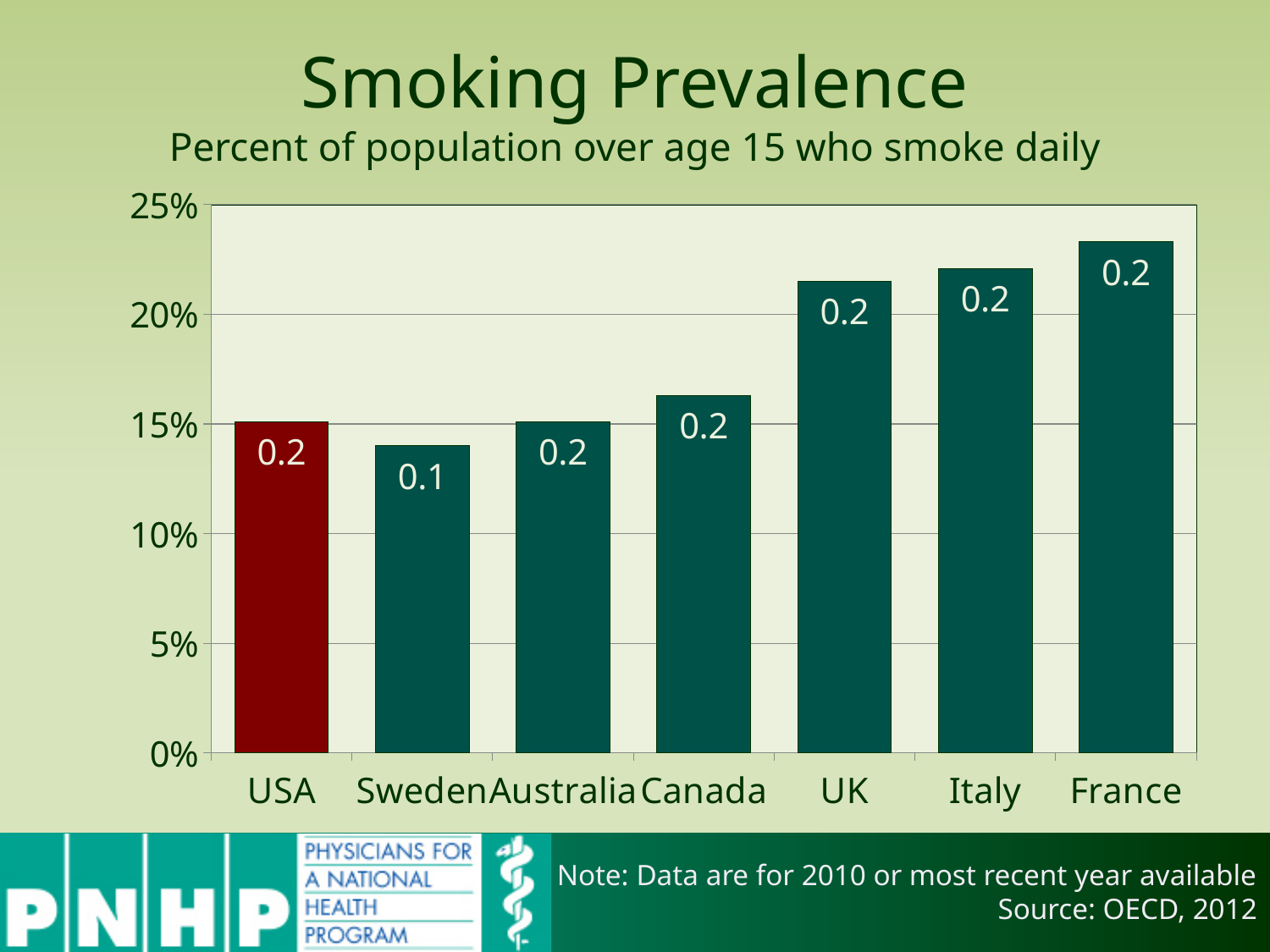
Is the value for France greater or less than 25%? less Is the value for Canada greater or less than 15%? greater Which country has the highest smoking prevalence in the chart? France What kind of chart is shown on the slide? bar chart Is the value for Sweden greater or less than 15%? less Which country's bar is coloured differently (dark red) from the others? USA How many countries are shown on the x axis of the chart? 7 Which has a higher smoking prevalence, UK or Canada? UK Do the values rise or fall moving along the x axis from Sweden to France? rise Which country has the lowest smoking prevalence in the chart? Sweden